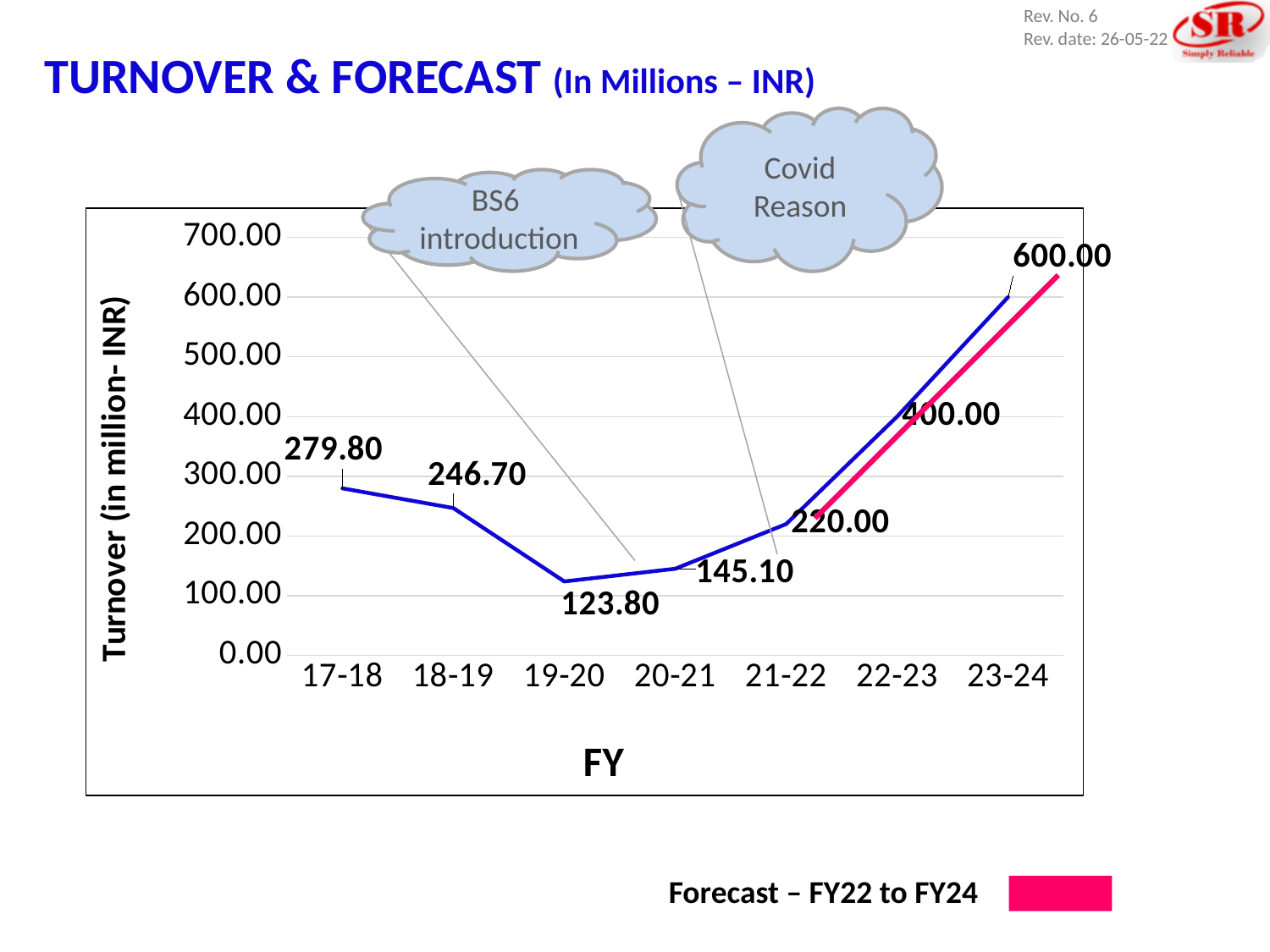
What is the turnover value for FY 21-22? 220.00 How many fiscal years are plotted on the x axis? 7 What is the difference between the turnover values for FY 17-18 and FY 18-19? 33.10 What is the turnover value for FY 17-18? 279.80 Which fiscal year has the lowest turnover value? 19-20 What is the turnover value for FY 19-20? 123.80 What is the forecast turnover value for FY 23-24? 600.00 What type of chart is shown on the slide? line chart What is the label of the y axis? Turnover (in million- INR) Which is larger, the turnover value for FY 20-21 or FY 21-22? 21-22 Which fiscal year has the highest turnover value? 23-24 Do the turnover values rise or fall from FY 19-20 to FY 23-24? rise